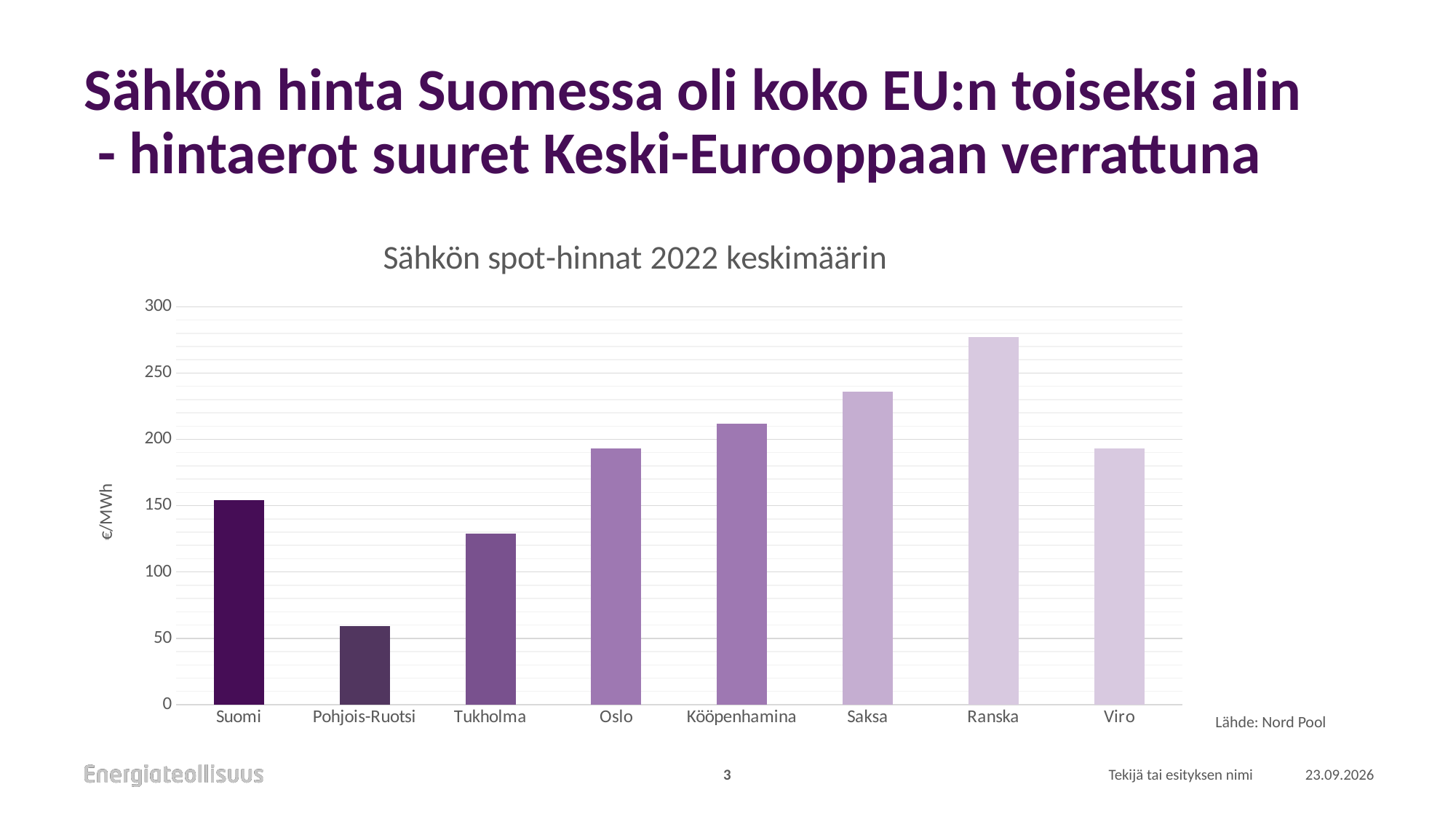
Is the value for Ranska greater or less than 250? greater What kind of chart is shown on the slide? bar chart Is the value for Pohjois-Ruotsi greater or less than 100? less What unit is shown on the y axis of the chart? €/MWh What is the title of the chart? Sähkön spot-hinnat 2022 keskimäärin Which category has the lowest average spot price in the chart? Pohjois-Ruotsi How many categories (price areas) are shown on the x axis of the chart? 8 Which is larger, the value for Suomi or the value for Oslo? Oslo Which category has the highest average spot price in the chart? Ranska Is the value for Tukholma greater or less than 150? less Which is larger, the value for Saksa or the value for Kööpenhamina? Saksa